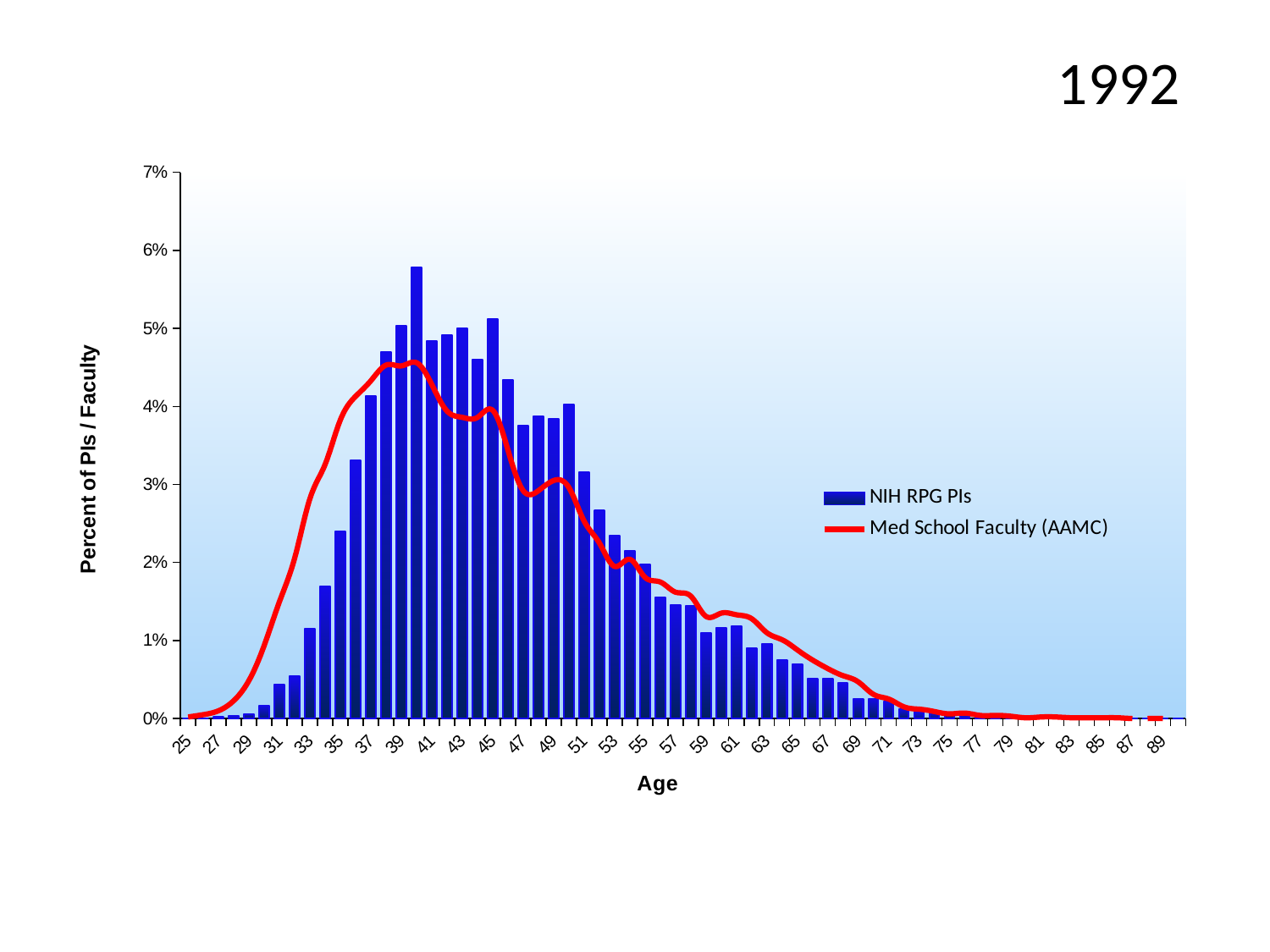
Which is larger for NIH RPG PIs: the bar at age 40 or the bar at age 45? Age 40 Is the NIH RPG PIs value for age 51 greater or less than 3%? greater Is the NIH RPG PIs value for age 40 greater or less than 5%? greater Which is larger for NIH RPG PIs: the bar at age 37 or the bar at age 55? Age 37 Is the NIH RPG PIs value for age 65 greater or less than 1%? less Do the NIH RPG PIs bars generally rise or fall from age 51 to age 71? Fall At which age is the NIH RPG PIs bar the tallest? 40 What kind of chart is shown on the slide? Bar chart with a line overlay Which series is drawn as a red line? Med School Faculty (AAMC) What is the title of the y axis? Percent of PIs / Faculty How many series does the legend list? 2